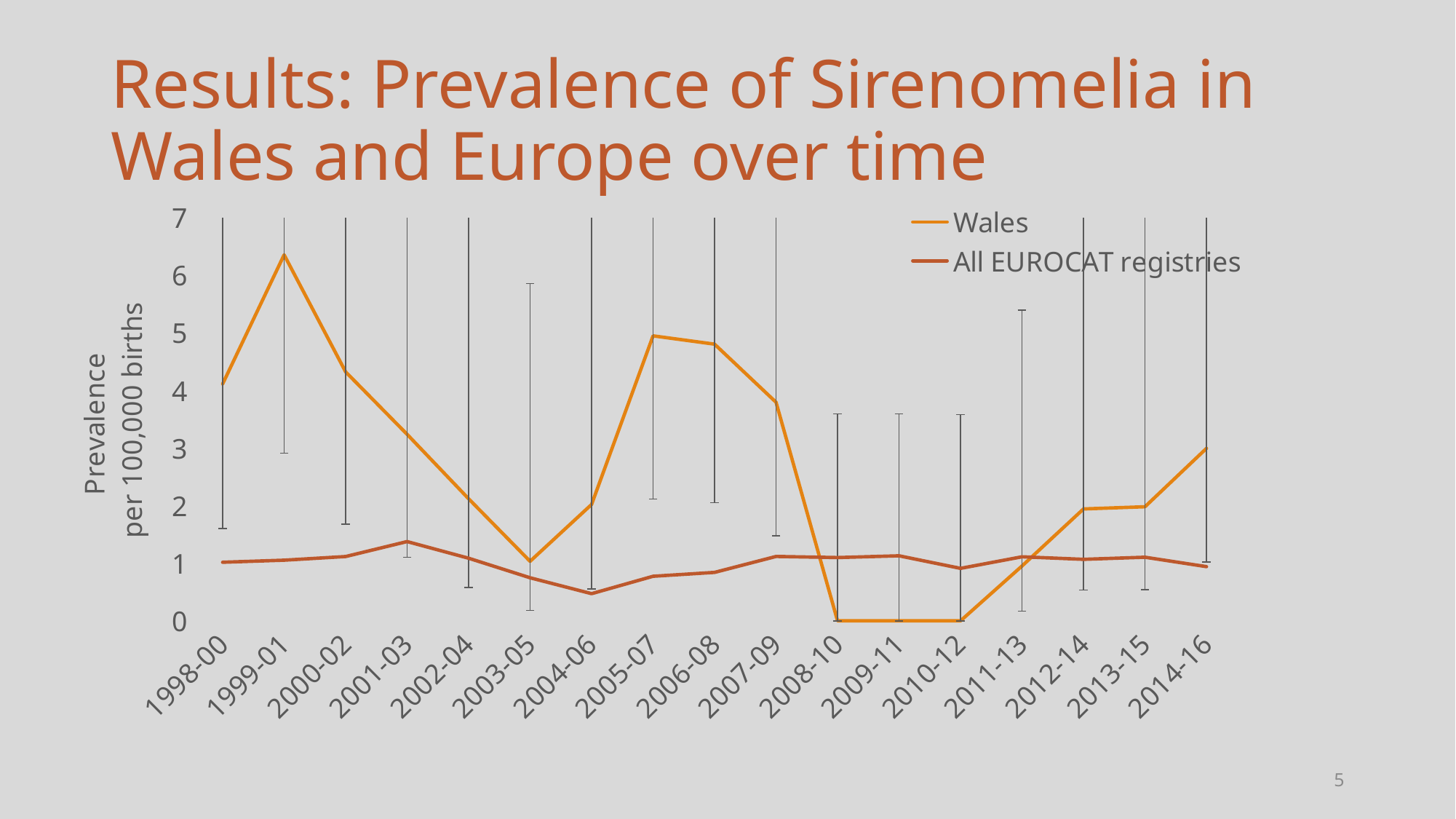
What kind of chart is shown on the slide? line chart Which series has the larger value in 1999-01, Wales or All EUROCAT registries? Wales Is the Wales value for 1999-01 greater or less than 6? greater What is the Wales prevalence for 2009-11? 0 How many time periods are shown along the x axis? 17 Is the All EUROCAT registries value for 2004-06 greater or less than 1? less What is the label on the y axis? Prevalence per 100,000 births Is the Wales value for 2005-07 greater or less than 4? greater Does the Wales line rise or fall from 1999-01 to 2003-05? fall In which period is the Wales prevalence highest? 1999-01 Which series has the larger value in 2010-12, Wales or All EUROCAT registries? All EUROCAT registries How many series does the legend list? 2